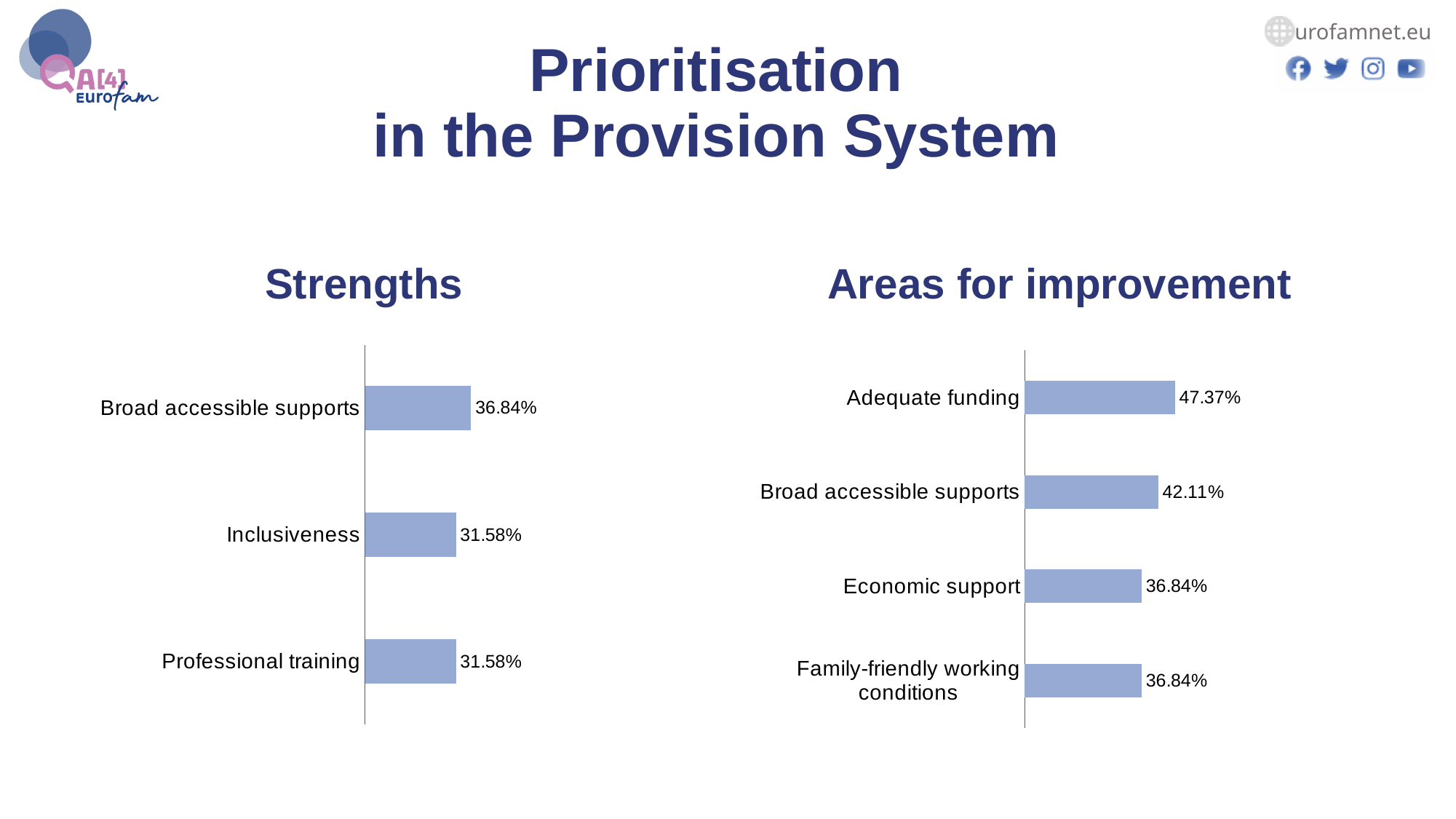
What type of chart is the Strengths chart? Bar chart In the Strengths chart, which category has the highest value? Broad accessible supports In the Strengths chart, what is the value for Inclusiveness? 31.58% In the Areas for improvement chart, which category has the highest value? Adequate funding In the Areas for improvement chart, what is the value for Adequate funding? 47.37% In the Areas for improvement chart, what is the value for Economic support? 36.84% How many categories are shown in the Strengths chart? 3 In the Strengths chart, what is the difference between Broad accessible supports and Professional training? 5.26% In the Areas for improvement chart, what is the difference between Adequate funding and Broad accessible supports? 5.26% In the Strengths chart, what is the value for Broad accessible supports? 36.84% How many categories are shown in the Areas for improvement chart? 4 In the Areas for improvement chart, which is larger: Broad accessible supports or Economic support? Broad accessible supports